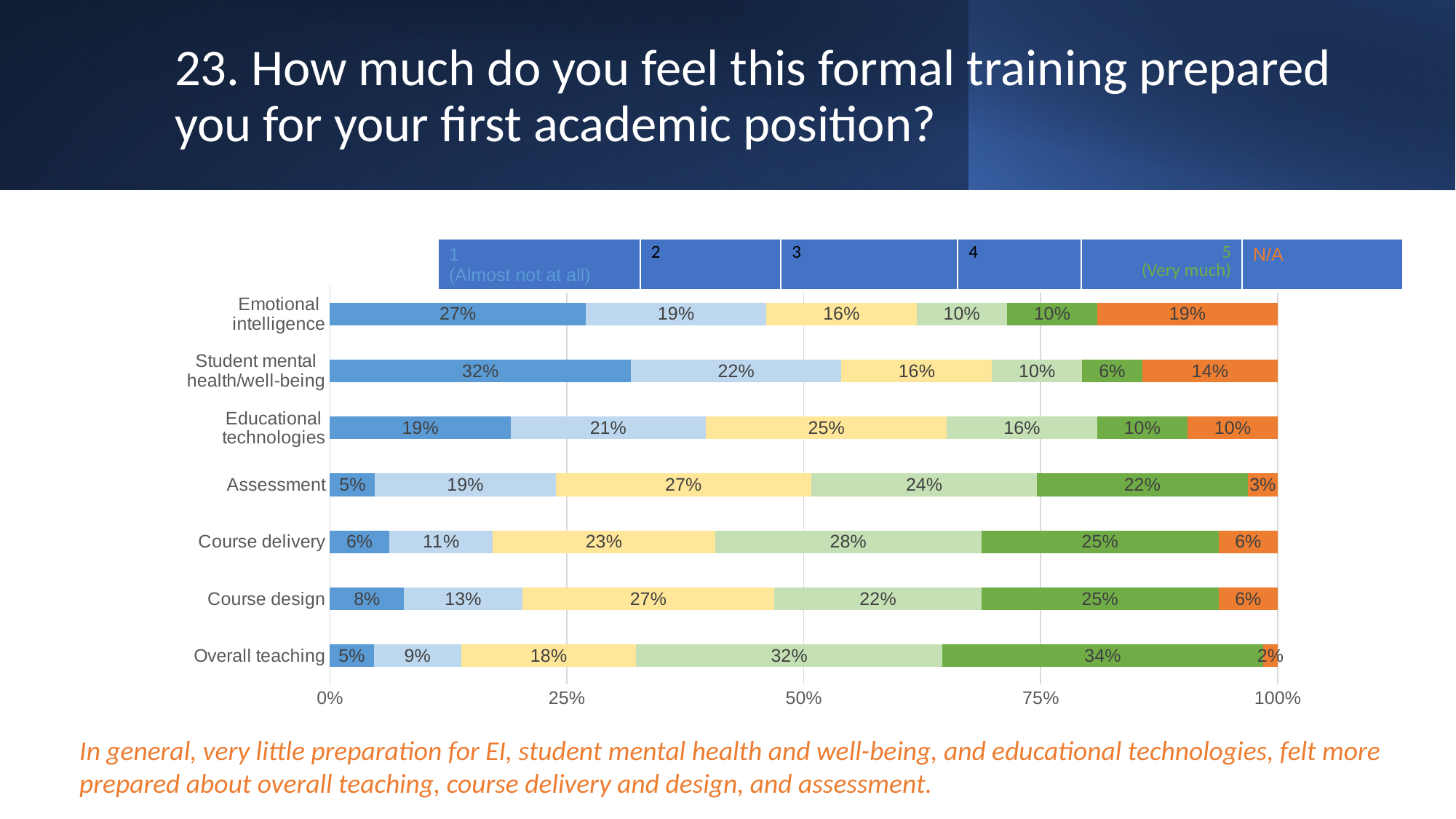
How many categories are shown on the chart? 7 What is the N/A percentage for Student mental health/well-being? 14% What is the value of the '3' segment for Educational technologies? 25% Which category has the smallest N/A share? Overall teaching What percentage of respondents rated Overall teaching as 5 (Very much)? 34% Which category has the largest '1 (Almost not at all)' share? Student mental health/well-being Which category has the largest '5 (Very much)' share? Overall teaching How many percentage points higher is the '1 (Almost not at all)' share for Student mental health/well-being than for Emotional intelligence? 5 percentage points How many series does the legend list? 6 What percentage of respondents rated Emotional intelligence as 1 (Almost not at all)? 27% Which has a larger '3' share: Assessment or Course delivery? Assessment What type of chart is shown on the slide? Stacked bar chart